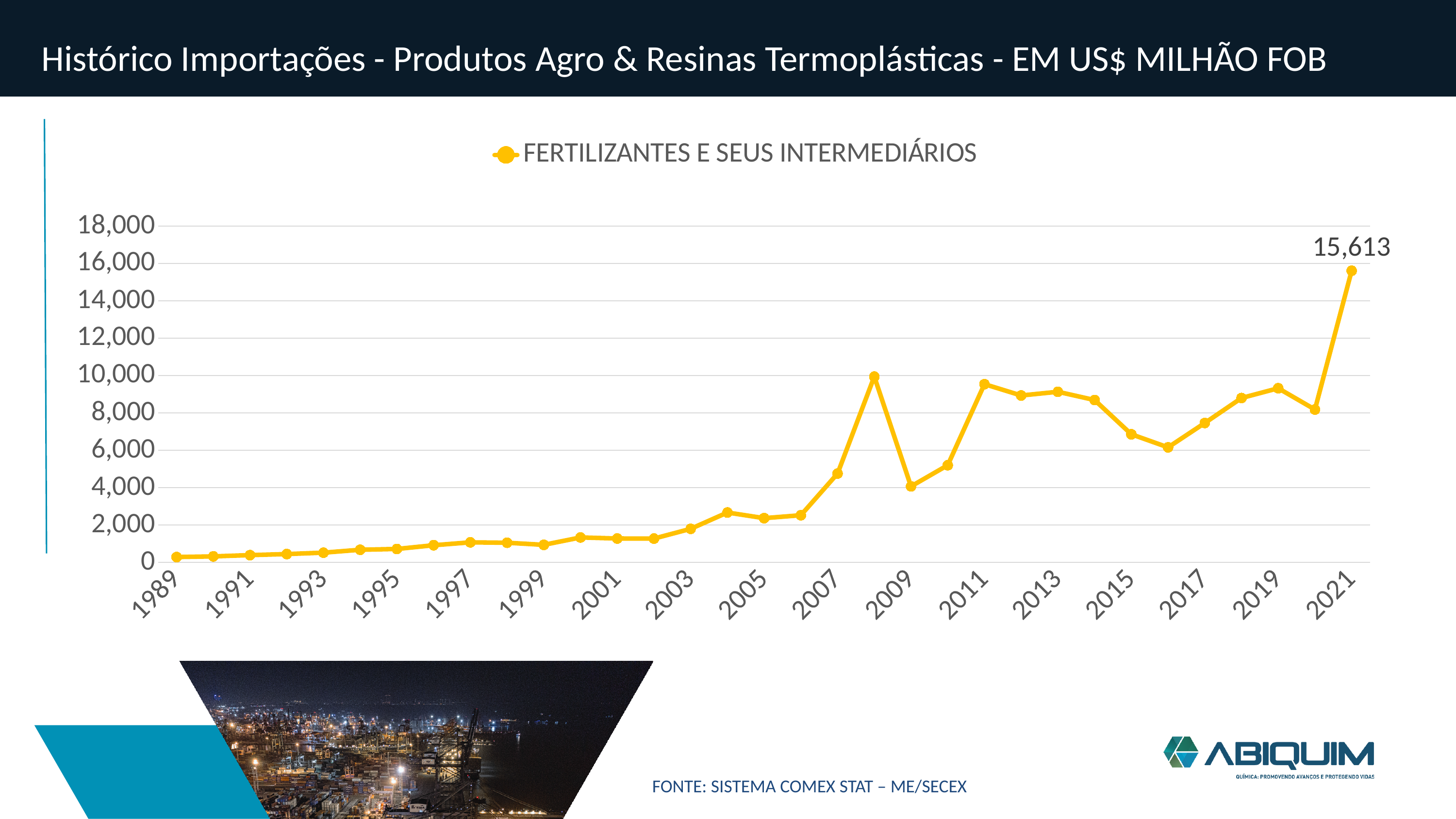
Is the value for 2009 greater or less than 6,000? less How many data points are plotted on the line? 33 Which year has the highest value for FERTILIZANTES E SEUS INTERMEDIÁRIOS? 2021 How many series does the legend list? 1 Which year has the larger value, 2020 or 2021? 2021 What type of chart is shown on the slide? line chart Which year has the larger value, 2008 or 2009? 2008 What is the value for 2021 for FERTILIZANTES E SEUS INTERMEDIÁRIOS? 15,613 Is the value for 2008 greater or less than 8,000? greater What is the name of the series shown in the legend? FERTILIZANTES E SEUS INTERMEDIÁRIOS Does the value rise or fall from 2020 to 2021? rise Is the value for 2016 greater or less than 8,000? less